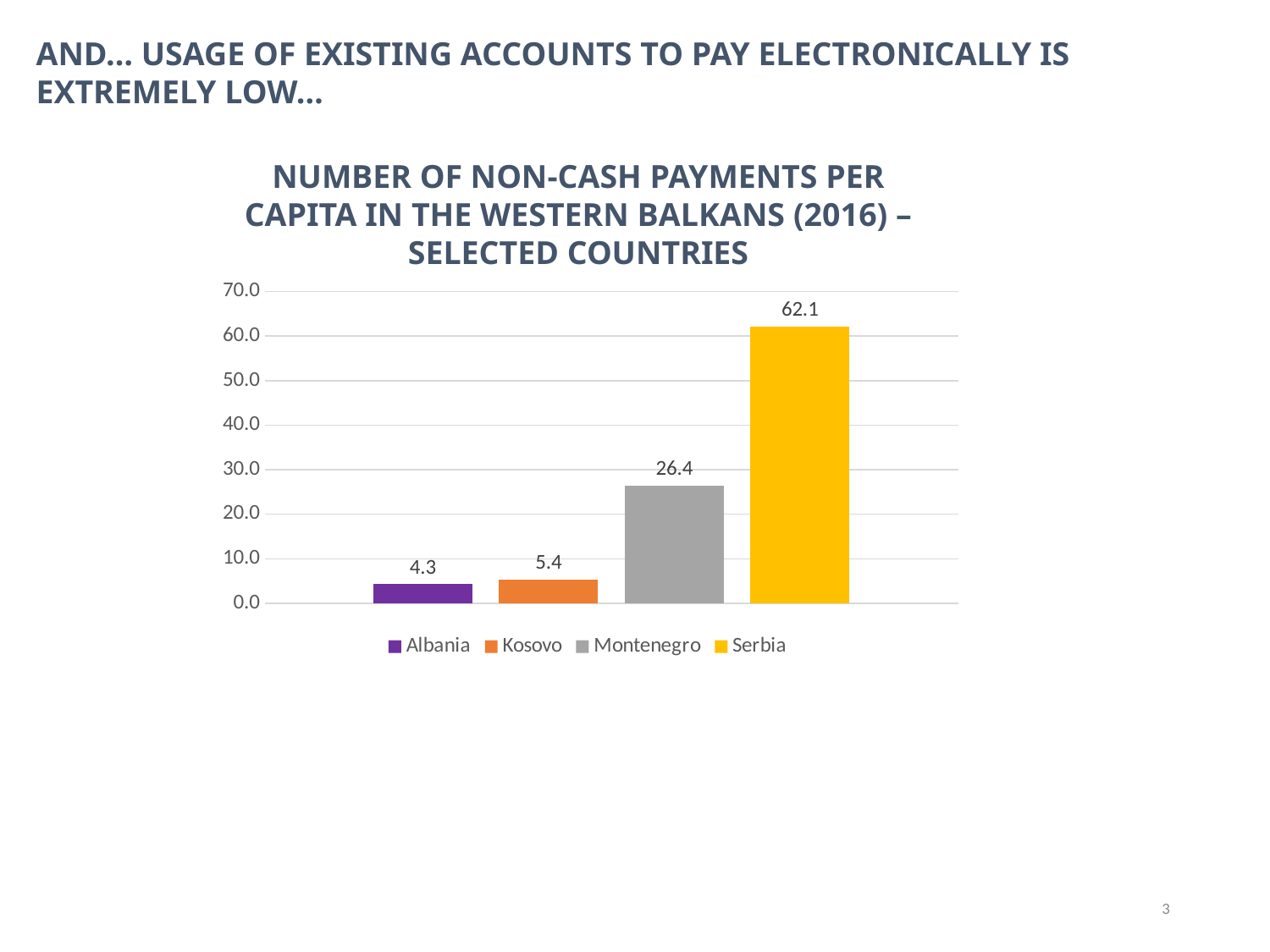
Which country has the lowest number of non-cash payments per capita? Albania What type of chart is shown on the slide? Bar chart What is the difference between Kosovo's and Albania's values? 1.1 What is the number of non-cash payments per capita for Kosovo? 5.4 Is the value for Serbia greater or less than 60.0? greater What is the number of non-cash payments per capita for Albania? 4.3 What is the difference between Serbia's and Montenegro's values? 35.7 Which country has the highest number of non-cash payments per capita? Serbia Which has a larger value, Montenegro or Kosovo? Montenegro What is the number of non-cash payments per capita for Serbia? 62.1 How many countries are shown in the chart? 4 What is the number of non-cash payments per capita for Montenegro? 26.4